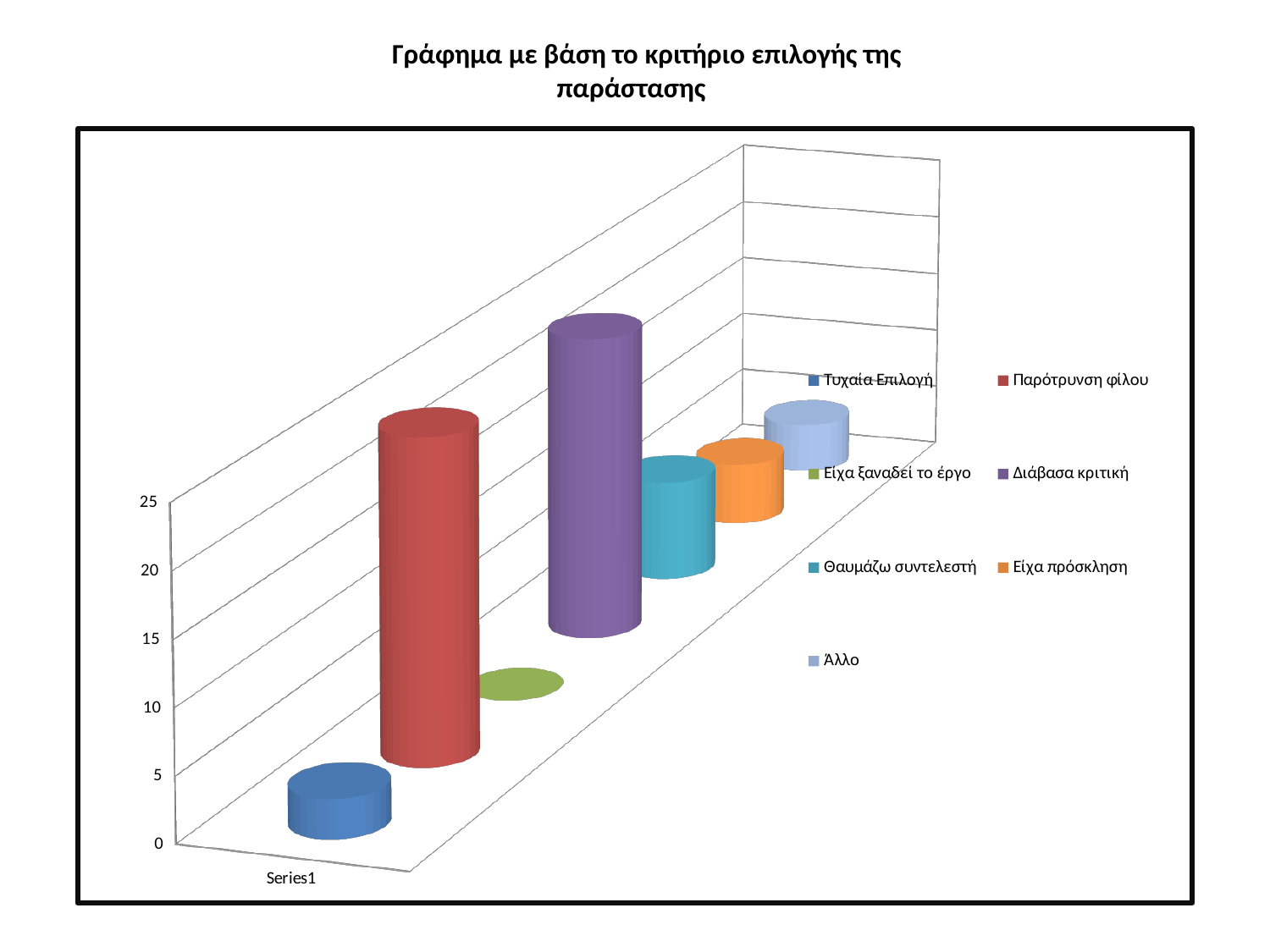
Is the value for Παρότρυνση φίλου greater or less than 15? greater Is the value for Είχα πρόσκληση greater or less than 10? less Which legend entry has the lowest bar? Είχα ξαναδεί το έργο Is the value for Θαυμάζω συντελεστή greater or less than 15? less Which is larger, the value for Παρότρυνση φίλου or the value for Τυχαία Επιλογή? Παρότρυνση φίλου What kind of chart is shown on the slide? bar chart How many bars are plotted in the chart? 7 How many entries does the legend list? 7 Which is larger, the value for Διάβασα κριτική or the value for Θαυμάζω συντελεστή? Διάβασα κριτική What is the title of the chart? Γράφημα με βάση το κριτήριο επιλογής της παράστασης